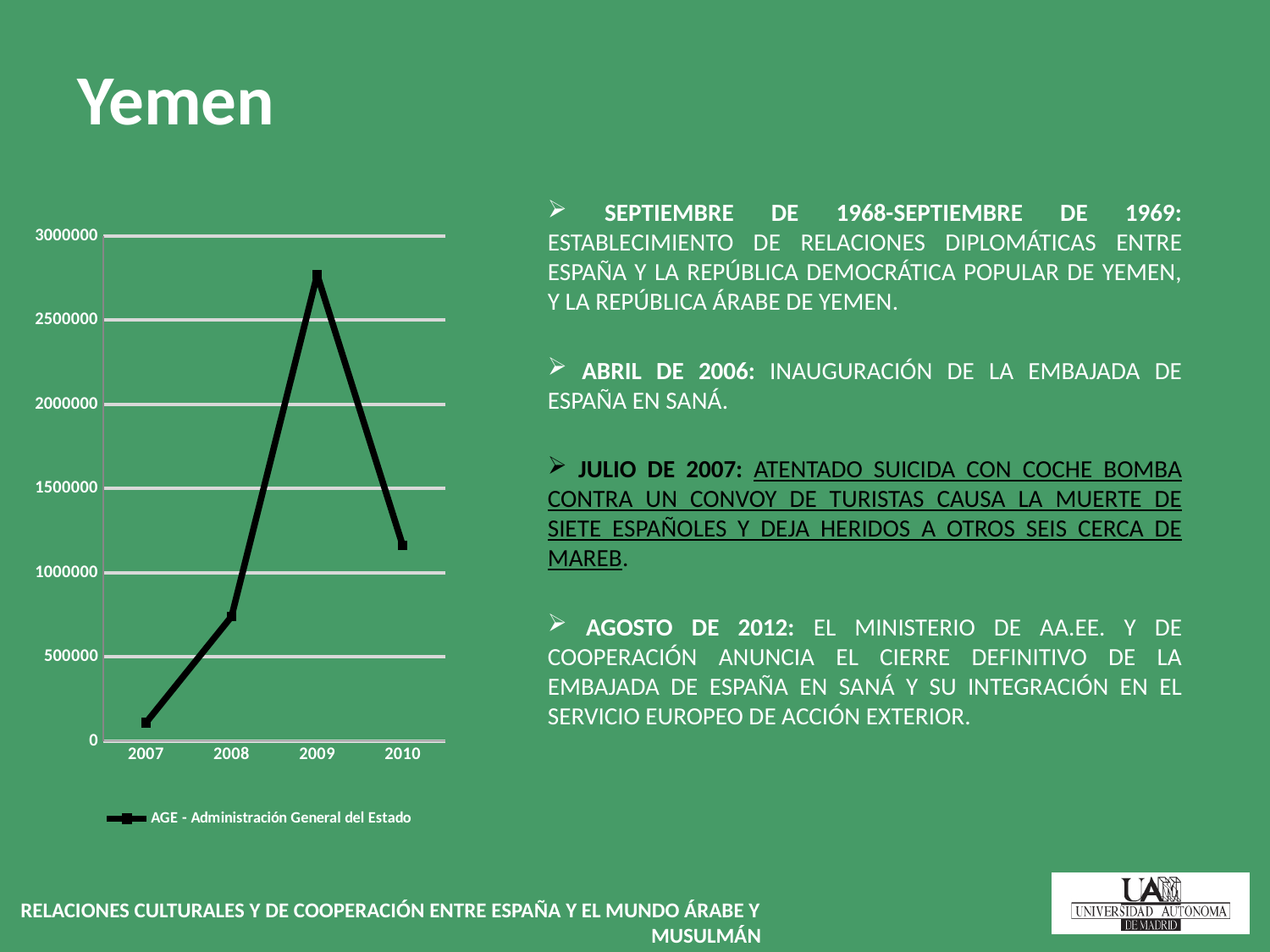
Which year has the larger value, 2008 or 2010? 2010 Is the value for 2007 greater or less than 500000? less Is the value for 2008 greater or less than 1000000? less Which year has the lowest value in the chart? 2007 Is the value for 2010 greater or less than 1000000? greater Does the value rise or fall from 2009 to 2010? fall How many years are plotted along the x axis of the chart? 4 What is the name of the series shown in the chart's legend? AGE - Administración General del Estado Which year has the highest value in the chart? 2009 What kind of chart is shown on the slide? line chart How many series does the chart's legend list? 1